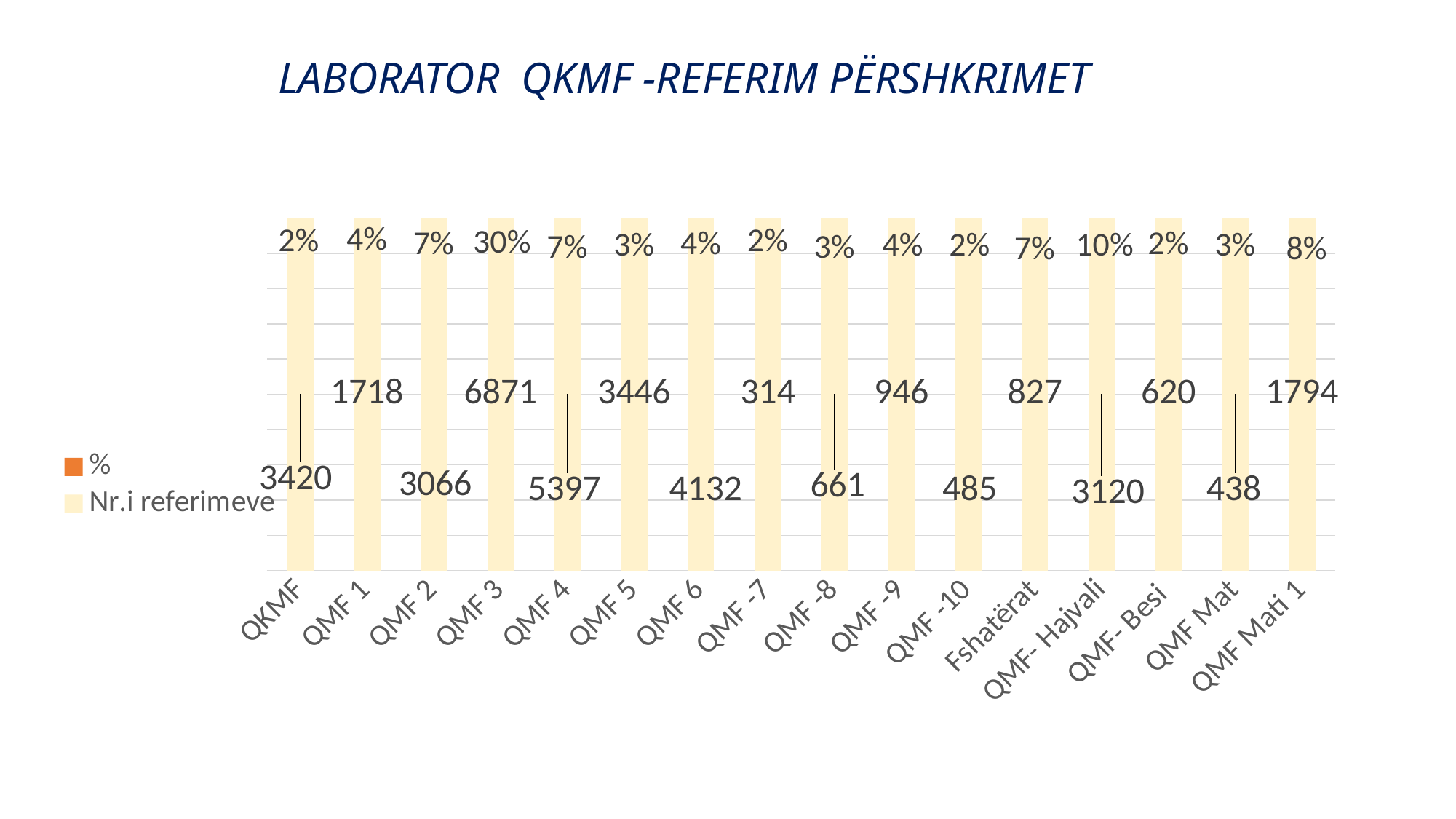
What is the Nr.i referimeve value for QMF 3? 6871 How many series does the legend list? 2 Which category has the highest Nr.i referimeve value? QMF 3 Which has a larger Nr.i referimeve value, QKMF or QMF- Hajvali? QKMF What percentage is shown for QMF Mati 1? 8% Which category has the lowest Nr.i referimeve value? QMF -7 How many categories are shown on the x axis? 16 What is the Nr.i referimeve value for QMF -7? 314 What is the difference between the Nr.i referimeve values for QMF 4 and QMF 6? 1265 Which category has the highest percentage? QMF 3 What is the title of the chart? LABORATOR QKMF -REFERIM PËRSHKRIMET What percentage is shown for QMF- Hajvali? 10%